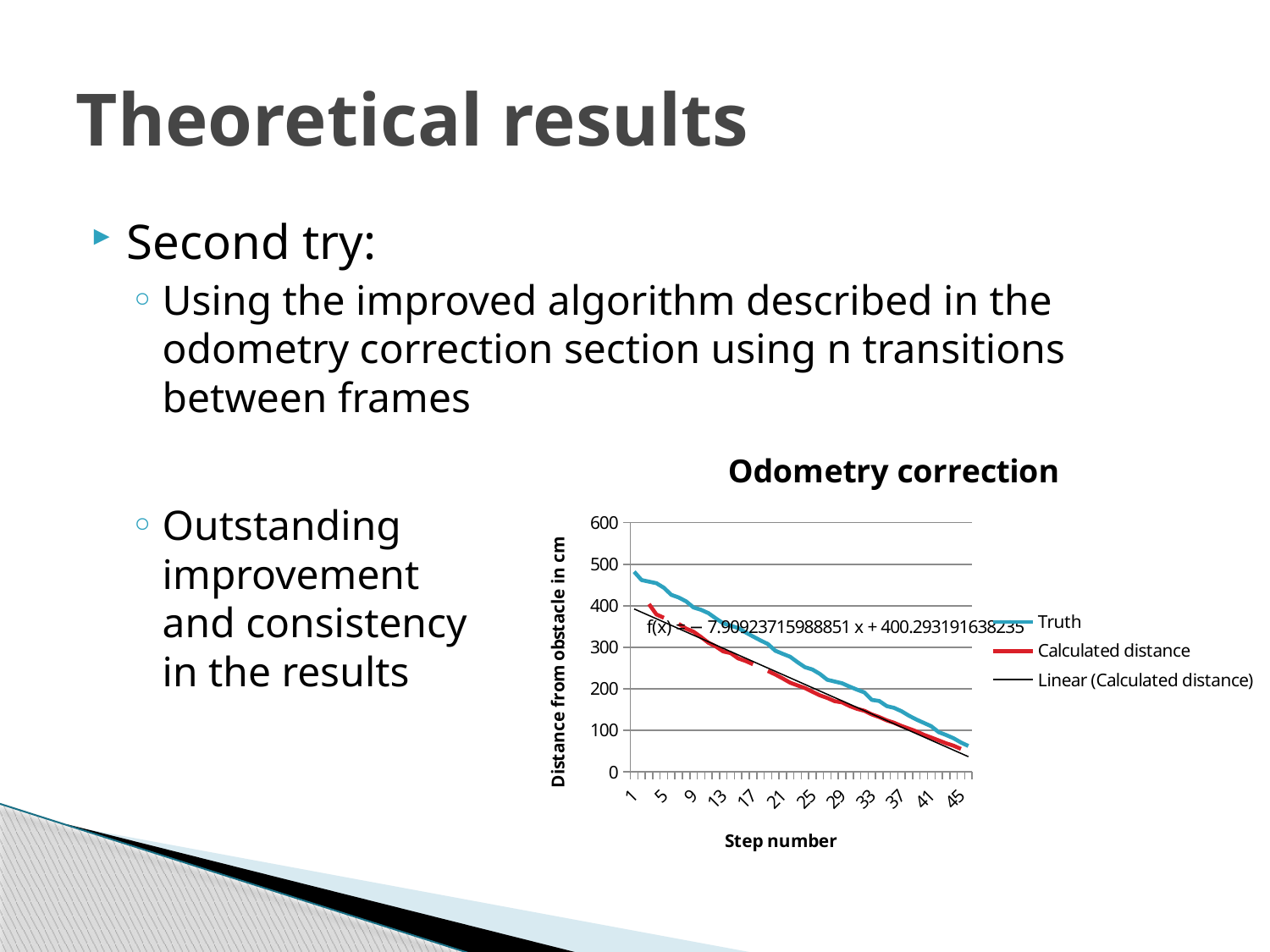
Do the values of the Truth series rise or fall as the step number increases? fall Is the value of the Truth series at step 1 greater or less than 500? less What is the title of the chart? Odometry correction What is the label of the y axis of the chart? Distance from obstacle in cm What kind of chart is shown on the slide? line chart Is the value of the Truth series at step 45 greater or less than 100? less Is the value of the Calculated distance series at step 25 greater or less than 300? less What is the intercept of the linear trendline equation shown on the chart? 400.293191638235 How many series does the chart legend list? 3 What is the slope of the linear trendline equation shown on the chart? -7.90923715988851